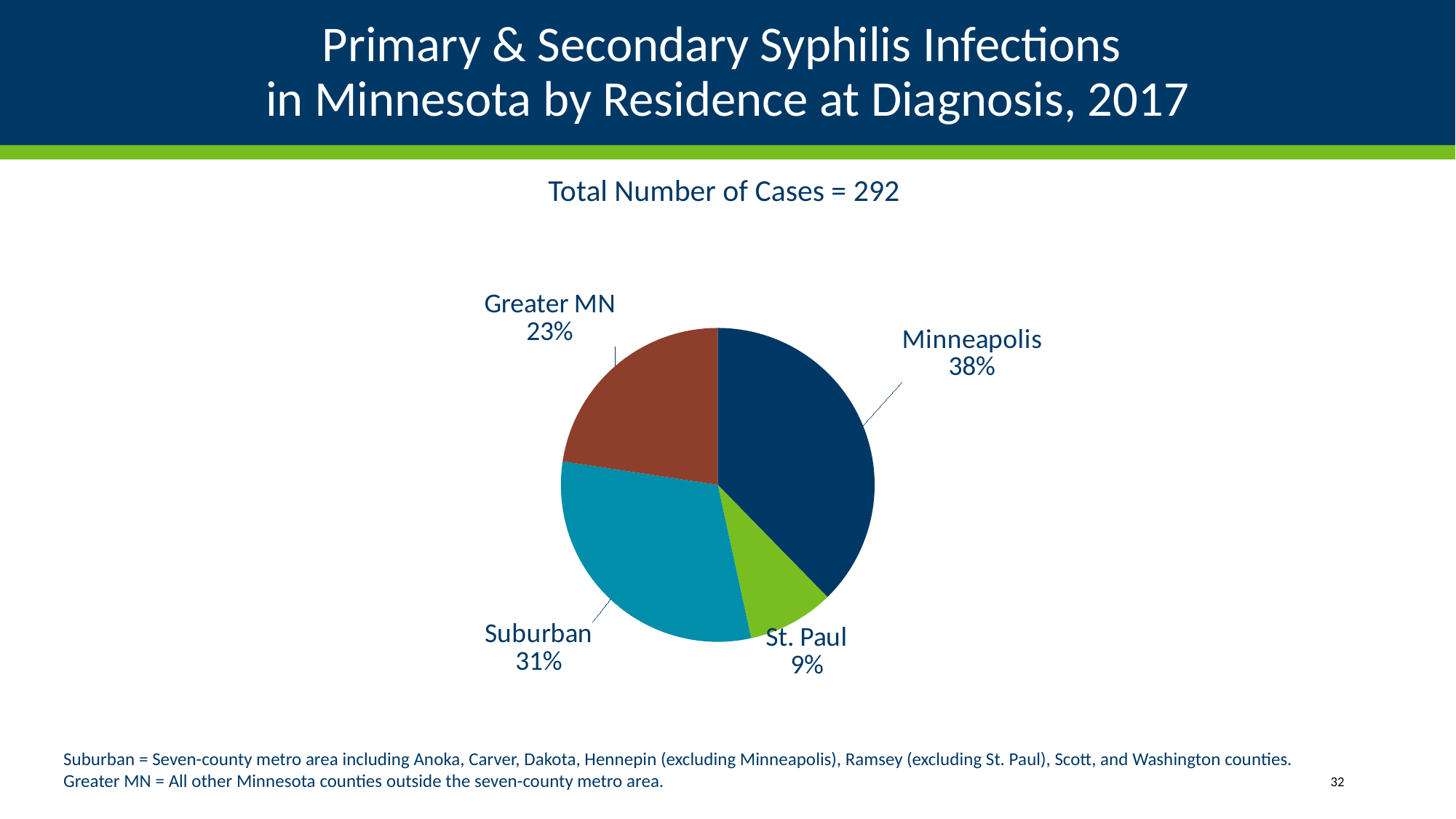
How many slices does the pie chart have? 4 What is the difference in percentage points between Minneapolis and Suburban? 7 What is the difference in percentage points between Greater MN and St. Paul? 14 What kind of chart is shown on the slide? Pie chart What is the total number of cases stated on the slide? 292 Which residence category has the largest share of cases? Minneapolis What share of the pie does Minneapolis represent? 38% What percentage is shown for St. Paul? 9% What percentage is shown for Suburban? 31% Which is larger, the share for Suburban or the share for Greater MN? Suburban Which residence category has the smallest share of cases? St. Paul What percentage is shown for Greater MN? 23%